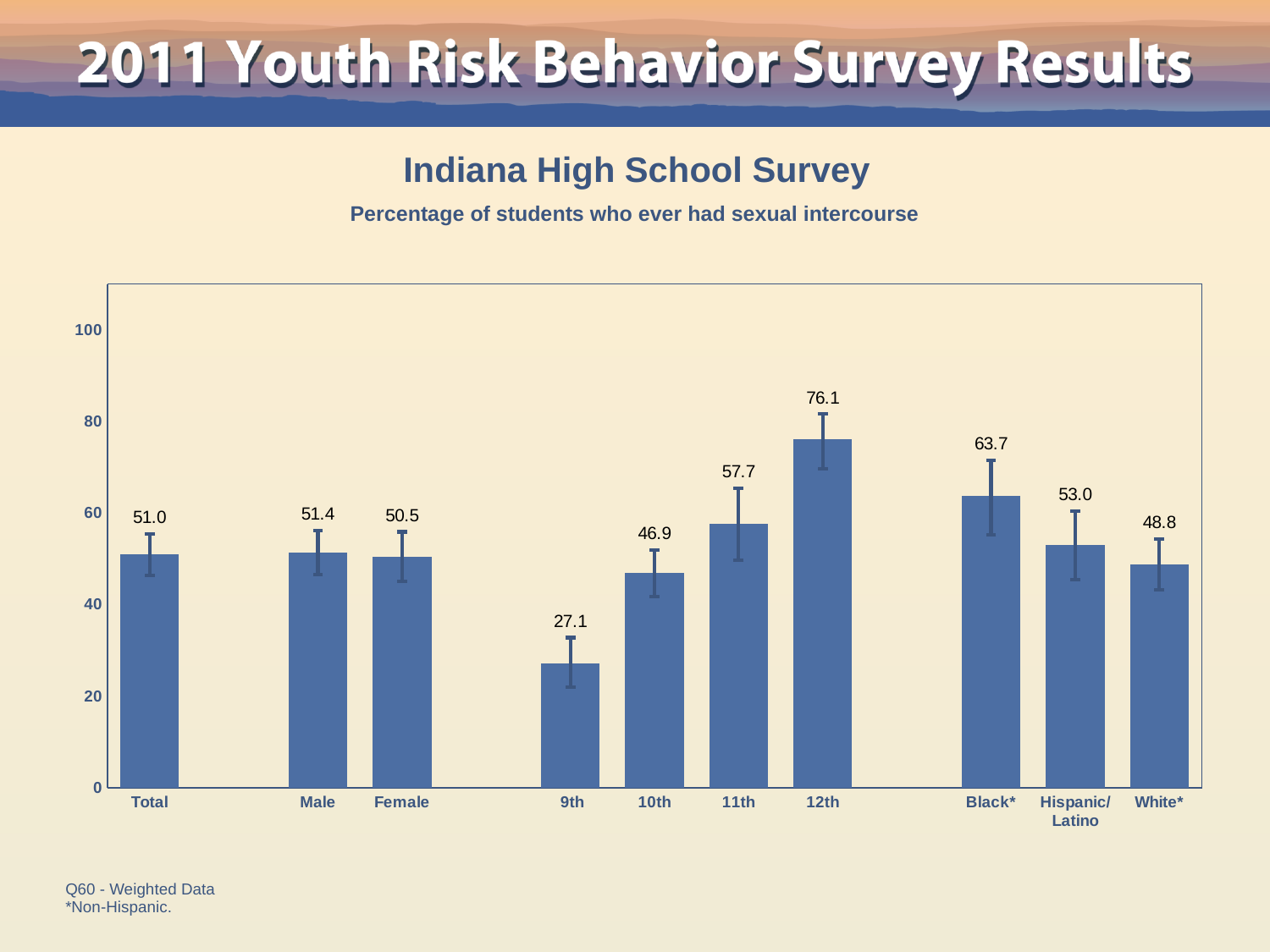
What is the value for 12th grade students? 76.1 How many categories are shown on the chart? 10 What is the value for Female students? 50.5 What is the difference between the values for 12th and 9th grade students? 49.0 What is the difference between the values for Black* and White* students? 14.9 Do the values rise or fall from 9th grade to 12th grade? rise What is the value for Hispanic/Latino students? 53.0 Which category has the highest value? 12th Which category has the lowest value? 9th Which is larger, the value for 11th grade or the value for Black* students? Black* What kind of chart is shown on the slide? bar chart Is the value for 10th grade students greater or less than 40? greater